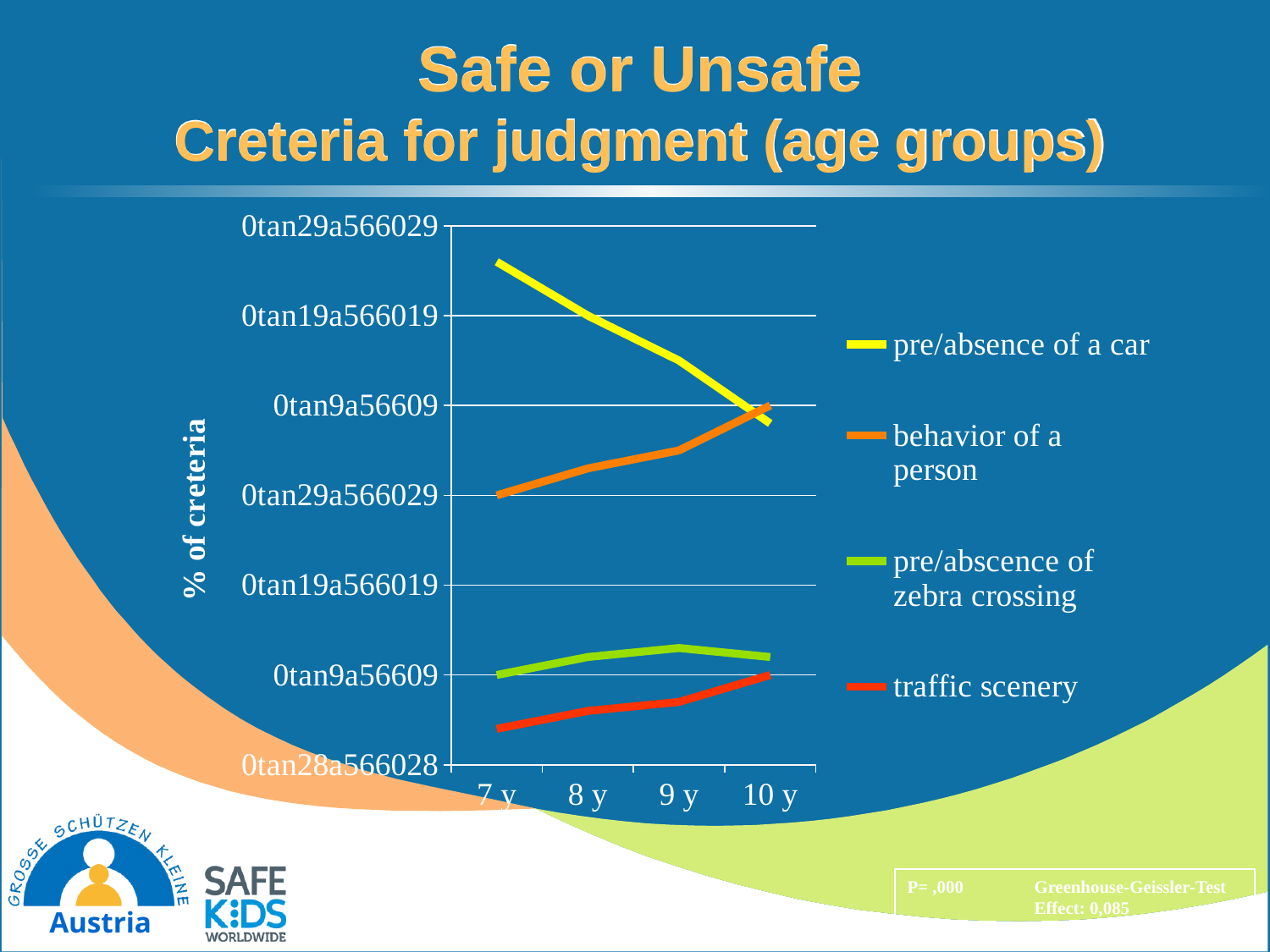
Which series has the lowest value at 7 y? traffic scenery Does the line for behavior of a person rise or fall from 7 y to 10 y? rise How many series does the legend list? 4 What is the title of the y axis? % of creteria At 8 y, which is larger: pre/absence of a car or behavior of a person? pre/absence of a car Does the line for pre/absence of a car rise or fall from 7 y to 10 y? fall Which series has the highest value at 7 y? pre/absence of a car Which series has the lowest value at 10 y? traffic scenery What kind of chart is shown on the slide? line chart At 9 y, which is larger: pre/abscence of zebra crossing or traffic scenery? pre/abscence of zebra crossing Does the line for traffic scenery rise or fall from 7 y to 10 y? rise How many age groups are shown on the x axis? 4